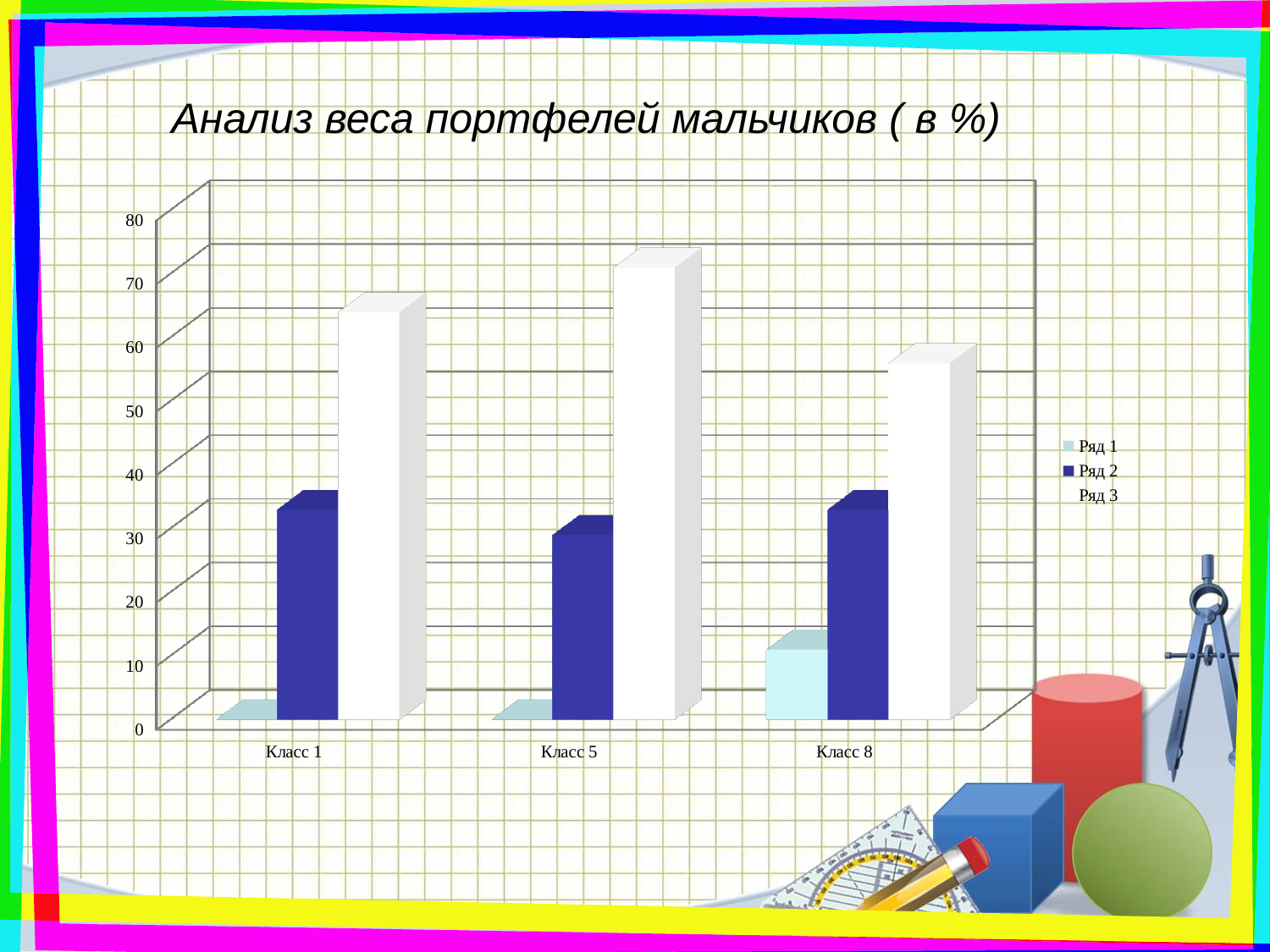
For which class is the Ряд 1 bar the highest? Класс 8 Which is larger for Ряд 3: Класс 1 or Класс 8? Класс 1 For which class is the Ряд 3 bar the lowest? Класс 8 For which class is the Ряд 3 bar the highest? Класс 5 How many categories are shown on the x axis of the chart? 3 What is the title of the chart? Анализ веса портфелей мальчиков ( в %) Is the value of Ряд 2 for Класс 5 greater or less than 40? less How many series does the chart legend list? 3 Which is larger for Класс 1: the Ряд 2 bar or the Ряд 3 bar? Ряд 3 Is the value of Ряд 3 for Класс 5 greater or less than 60? greater What kind of chart is shown on the slide? bar chart Is the value of Ряд 1 for Класс 8 greater or less than 20? less